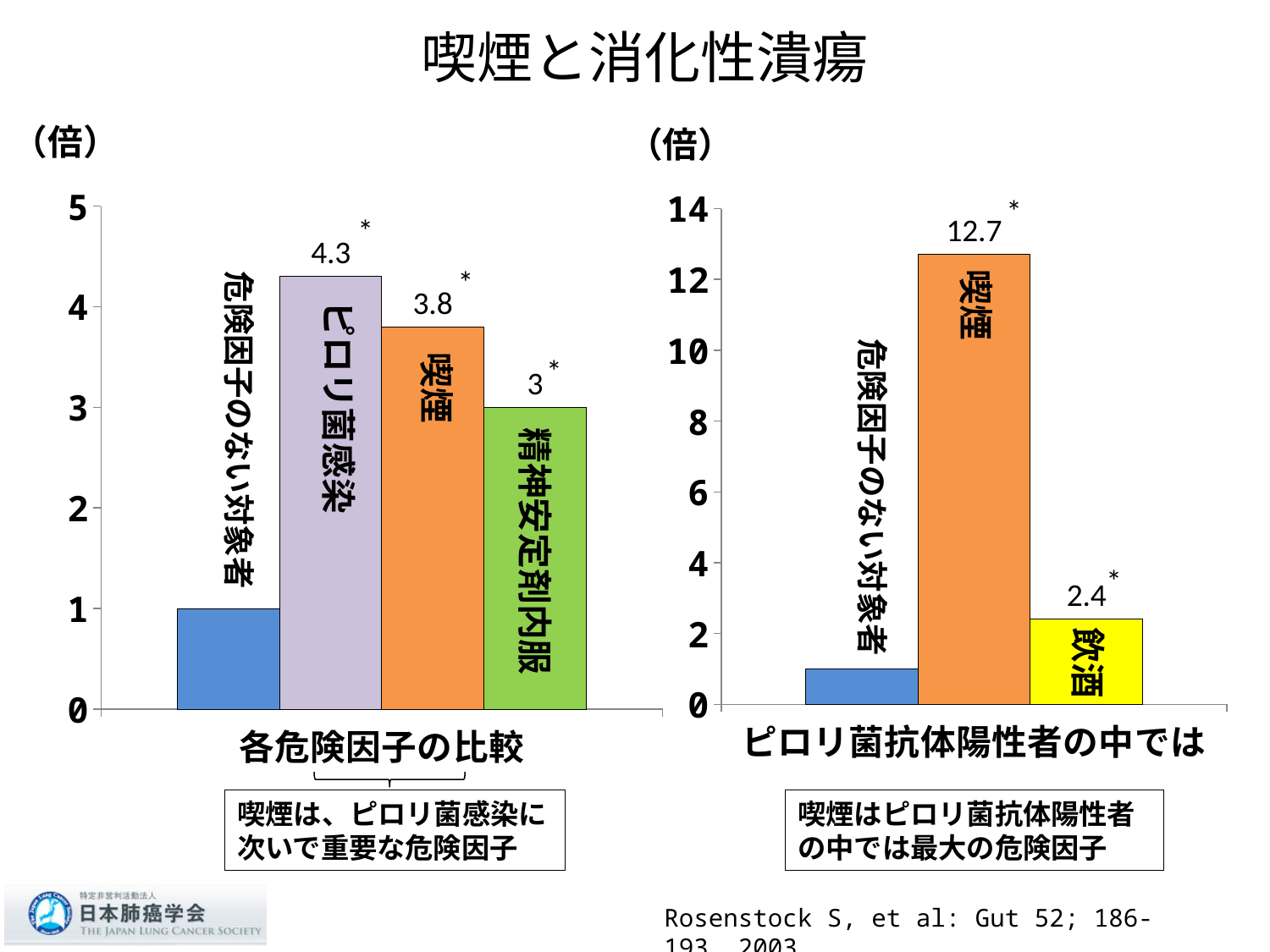
In the chart titled 各危険因子の比較, how many bars are plotted? 4 In the chart titled 各危険因子の比較, what is the value for 喫煙? 3.8 In the chart titled 各危険因子の比較, what is the value for ピロリ菌感染? 4.3 In the chart titled 各危険因子の比較, what is the value for 精神安定剤内服? 3 What kind of chart is the chart titled ピロリ菌抗体陽性者の中では? bar chart In the chart titled 各危険因子の比較, which category has the lowest value? 危険因子のない対象者 In the chart titled ピロリ菌抗体陽性者の中では, what is the value for 飲酒? 2.4 In the chart titled ピロリ菌抗体陽性者の中では, what is the value for 喫煙? 12.7 In the chart titled ピロリ菌抗体陽性者の中では, which category has the highest value? 喫煙 In the chart titled 各危険因子の比較, which category has the highest value? ピロリ菌感染 In the chart titled 各危険因子の比較, what is the difference between the values for ピロリ菌感染 and 喫煙? 0.5 In the chart titled ピロリ菌抗体陽性者の中では, is the value for 危険因子のない対象者 greater or less than 2? less